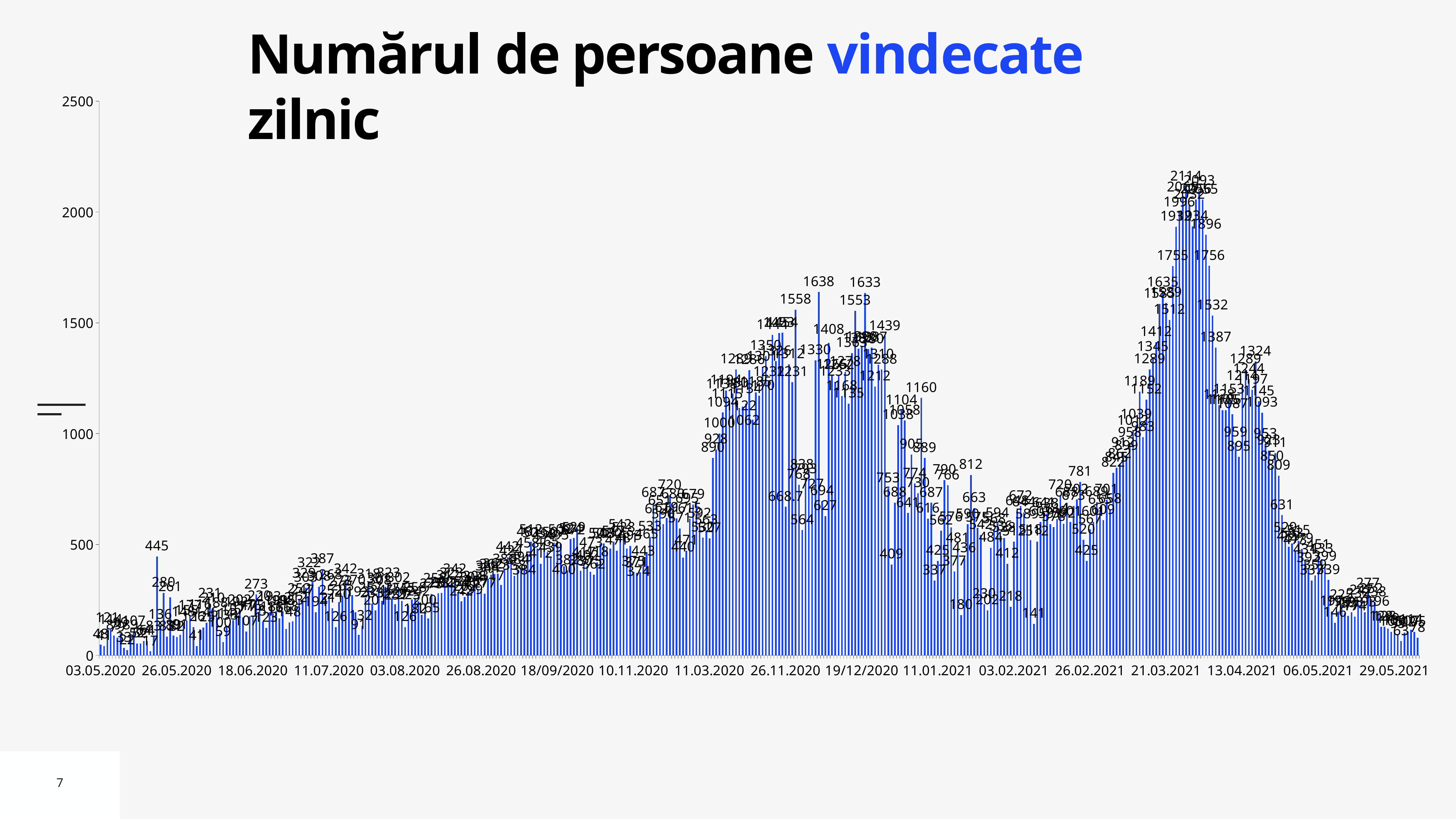
Do the values rise or fall between 26.02.2021 and 21.03.2021? rise What kind of chart is shown on the slide? bar chart What is the value of the tall spike just after 26.05.2020? 445 What is the highest tick value shown on the vertical axis? 2500 Is the value for the first date, 03.05.2020, greater or less than 500? less What is the highest daily value labeled on the chart? 2114 Is the value for the last date, 29.05.2021, greater or less than 500? less What is the title of the chart? Numărul de persoane vindecate zilnic What is the difference between the highest labeled value, 2114, and the late-2020 peak labeled 1638? 476 Are the values around 03.02.2021 greater or less than 1000? less Do the values rise or fall between 13.04.2021 and 29.05.2021? fall